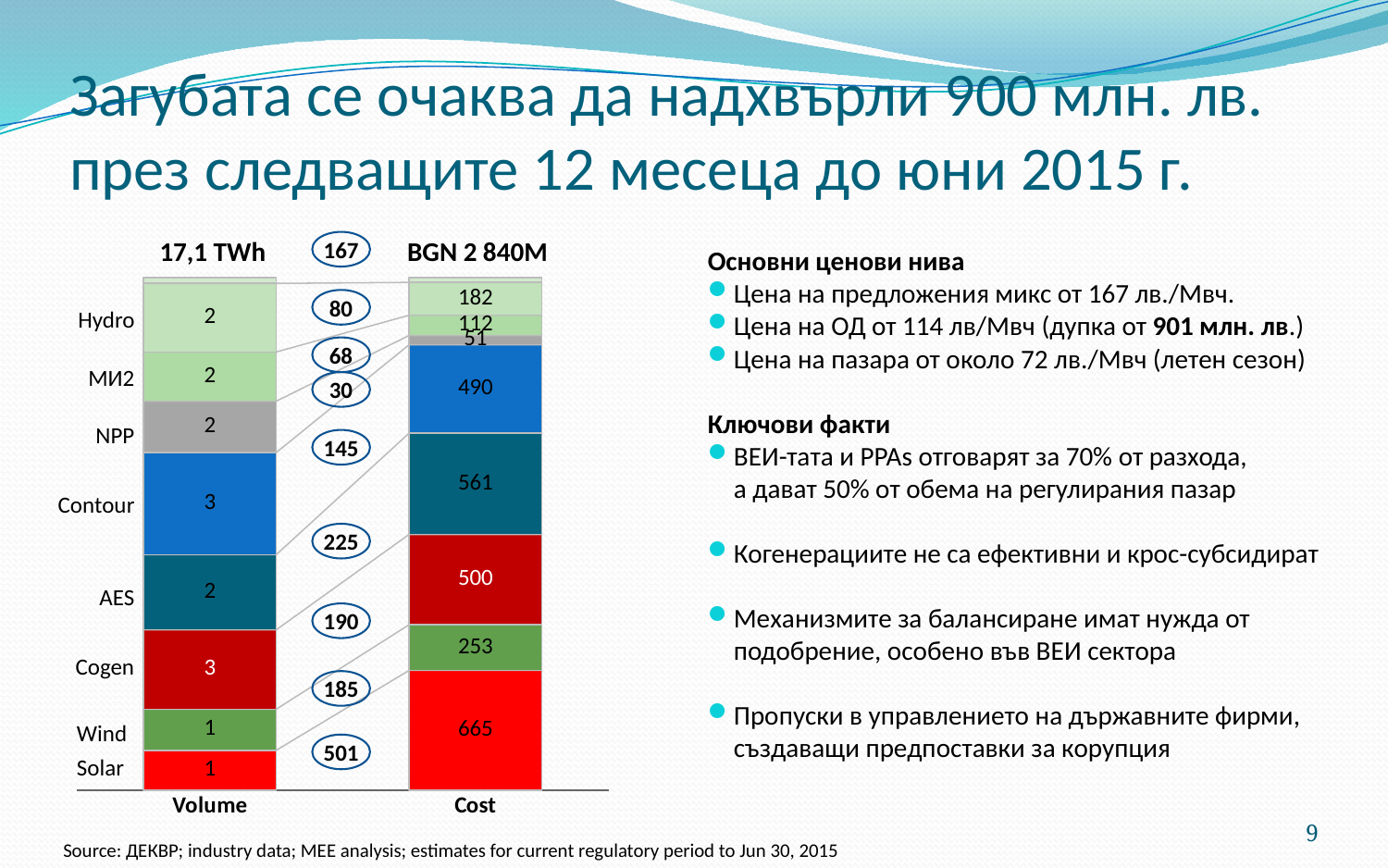
Which category has the highest Cost value? Solar How many categories are stacked in each bar? 8 What is the Cost value for Solar? 665 What is the difference between the Cost values for Cogen and Wind? 247 What is the Cost value for Wind? 253 Which category has the lowest Cost value? NPP What total is shown above the Volume bar? 17,1 TWh Which has a larger Cost value, Contour or Hydro? Contour What total is shown above the Cost bar? BGN 2 840M What kind of chart is shown on the slide? stacked bar chart What is the Cost value for AES? 561 What is the Volume value for Contour? 3